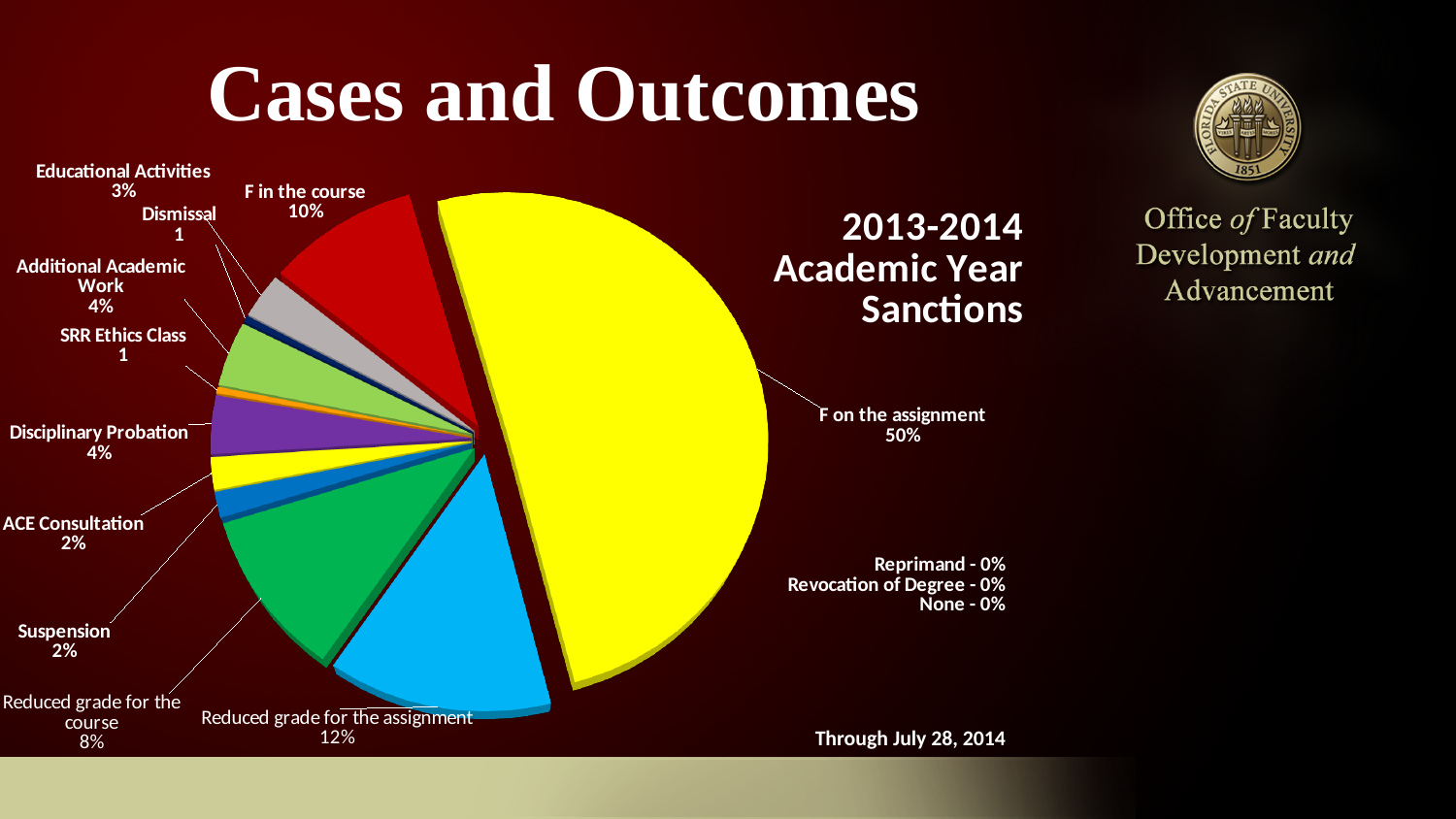
What is the value shown for "F in the course"? 10% What is the value shown for "Educational Activities"? 3% What is the value shown for "Disciplinary Probation"? 4% What is the title of the chart? 2013-2014 Academic Year Sanctions What kind of chart is shown on the slide? pie chart What is the difference between the shares for "F on the assignment" and "Reduced grade for the assignment"? 38% What share of the pie does "F on the assignment" represent? 50% What is the value shown for "Reduced grade for the assignment"? 12% Which is larger, "Reduced grade for the assignment" or "F in the course"? Reduced grade for the assignment Which sanction has the largest slice of the pie? F on the assignment Through what date does the chart's data run, according to the note on the slide? July 28, 2014 What is the value shown for "Reduced grade for the course"? 8%